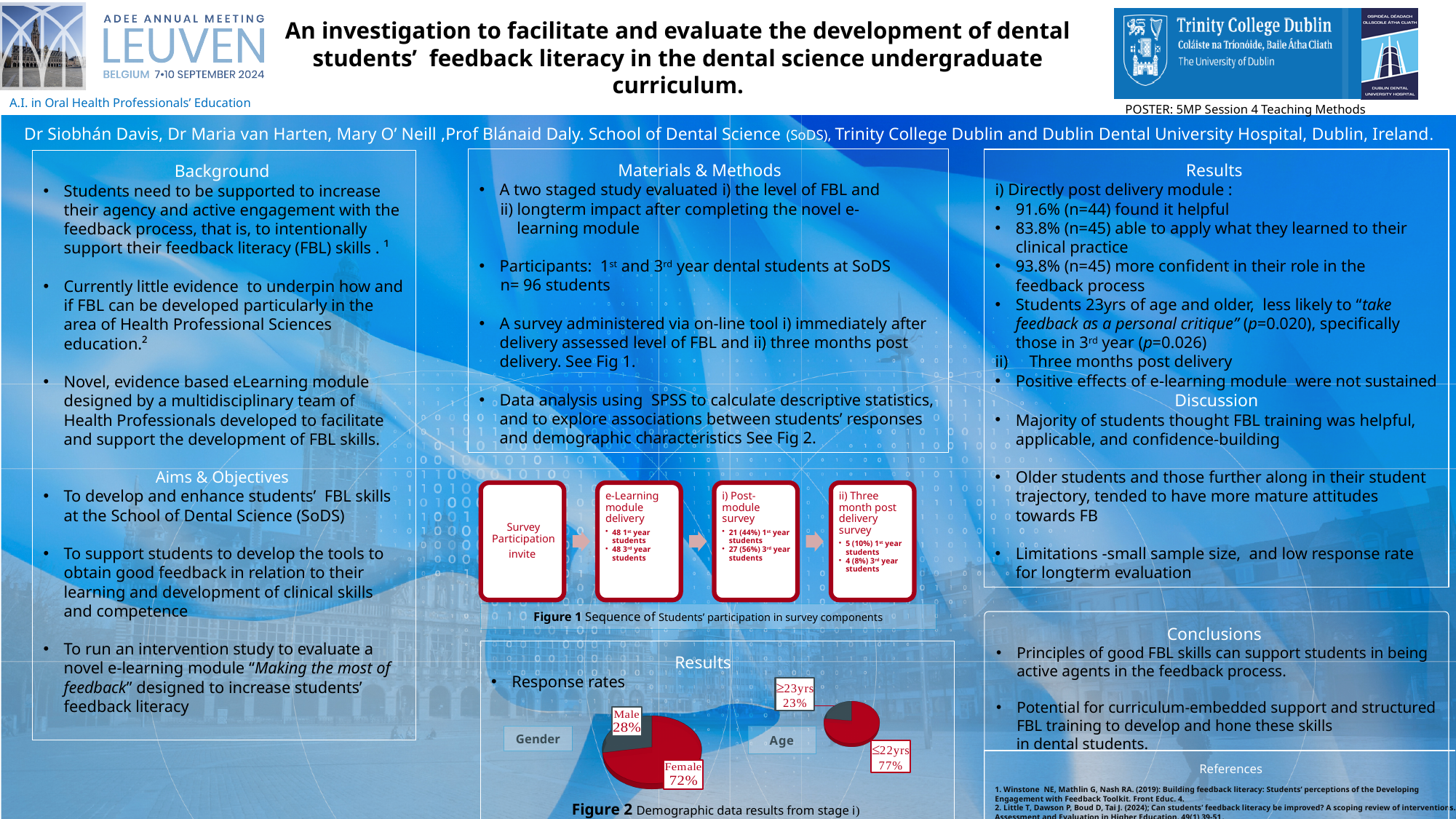
What is the caption of the figure containing the Gender and Age pie charts? Figure 2 Demographic data results from stage i) In the Gender pie chart, which category has the largest share? Female Which is larger: the Male share in the Gender pie chart or the ≥23yrs share in the Age pie chart? Male In the Age pie chart, what percentage of respondents are ≥23yrs? 23% In the Age pie chart, which category has the smallest share? ≥23yrs What type of chart is used to show the Age data in Figure 2? Pie chart In the Age pie chart, what percentage of respondents are ≤22yrs? 77% In the Age pie chart, what is the difference in percentage points between ≤22yrs and ≥23yrs? 54 In the Gender pie chart, what percentage of respondents are Male? 28% How many slices does the Gender pie chart have? 2 In the Gender pie chart, what percentage of respondents are Female? 72% In the Gender pie chart, what is the difference in percentage points between Female and Male? 44